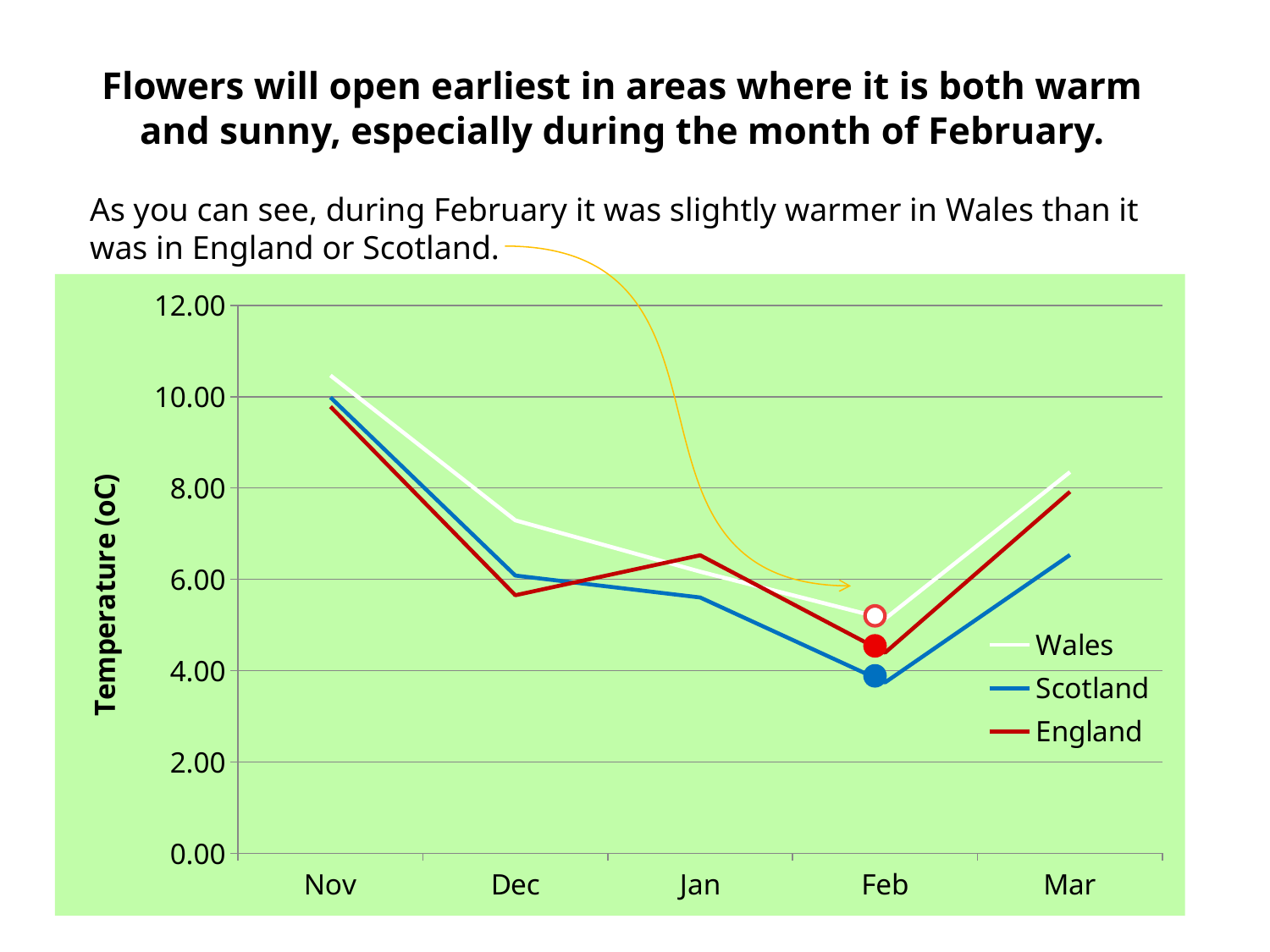
Is the temperature for Scotland in Feb greater or less than 6.00? less Which series has the lowest temperature in Feb? Scotland Is the temperature for Wales in Dec greater or less than 6.00? greater In which month is the Wales temperature highest? Nov Which series has the highest temperature in Feb? Wales In Jan, which is higher: the temperature for England or for Scotland? England What kind of chart is shown on the slide? line chart Is the temperature for Wales in Nov greater or less than 10.00? greater In which month is the Scotland temperature lowest? Feb How many months are shown along the x axis of the chart? 5 How many series does the chart's legend list? 3 What is the title of the vertical axis of the chart? Temperature (oC)